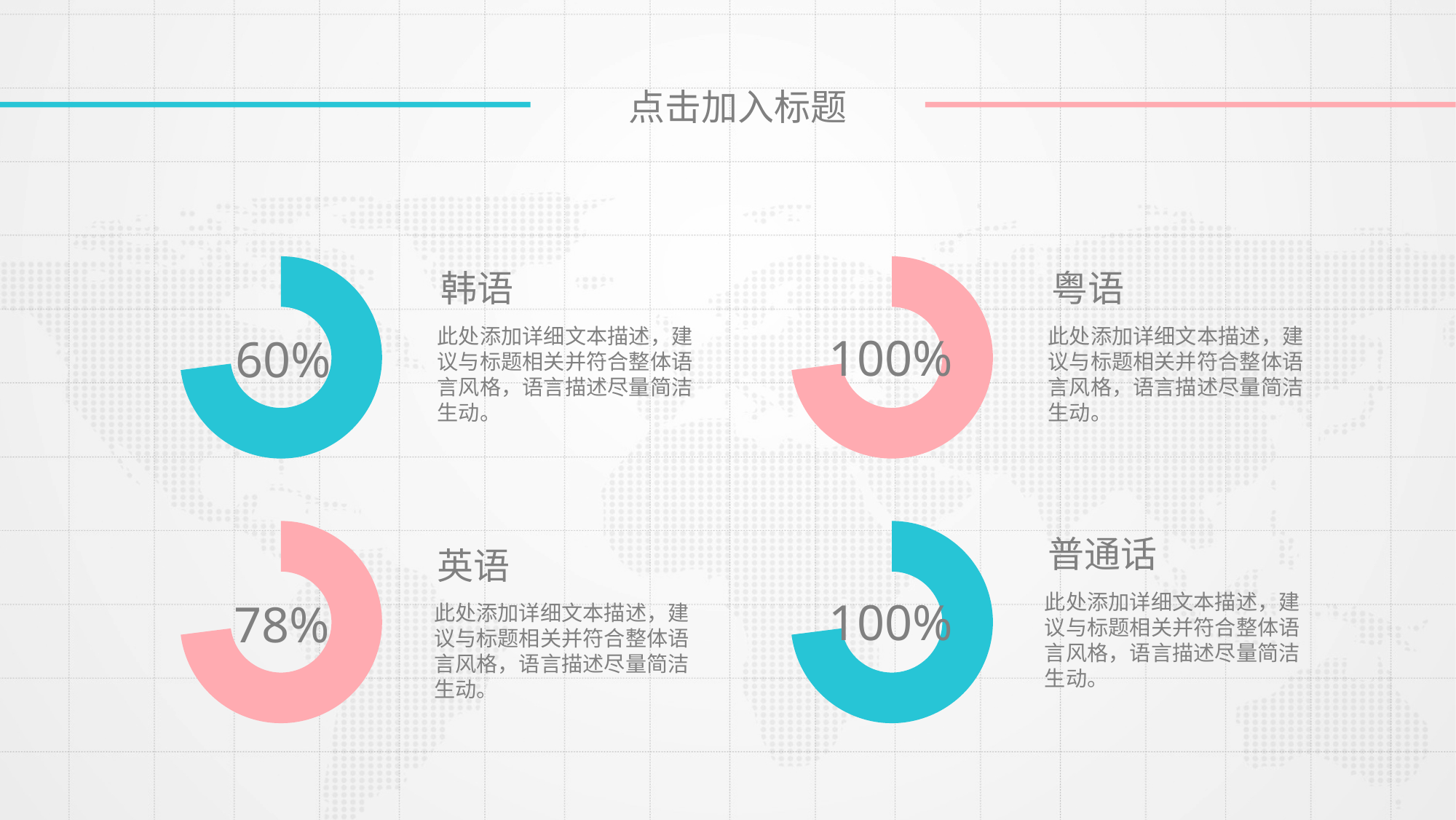
What percentage is shown for 粤语? 100% What kind of chart is used to show each language's percentage? Donut (ring) chart What is the difference between the percentages for 英语 and 韩语? 18% How many ring charts are shown on the slide? 4 What is the difference between the percentages for 粤语 and 韩语? 40% What colour is the ring chart for 韩语? Blue Which language has the lowest percentage on the slide? 韩语 What colour is the ring chart for 英语? Pink Which is larger, the percentage for 韩语 or for 英语? 英语 What percentage is shown for 韩语? 60% What percentage is shown for 英语? 78% What percentage is shown for 普通话? 100%